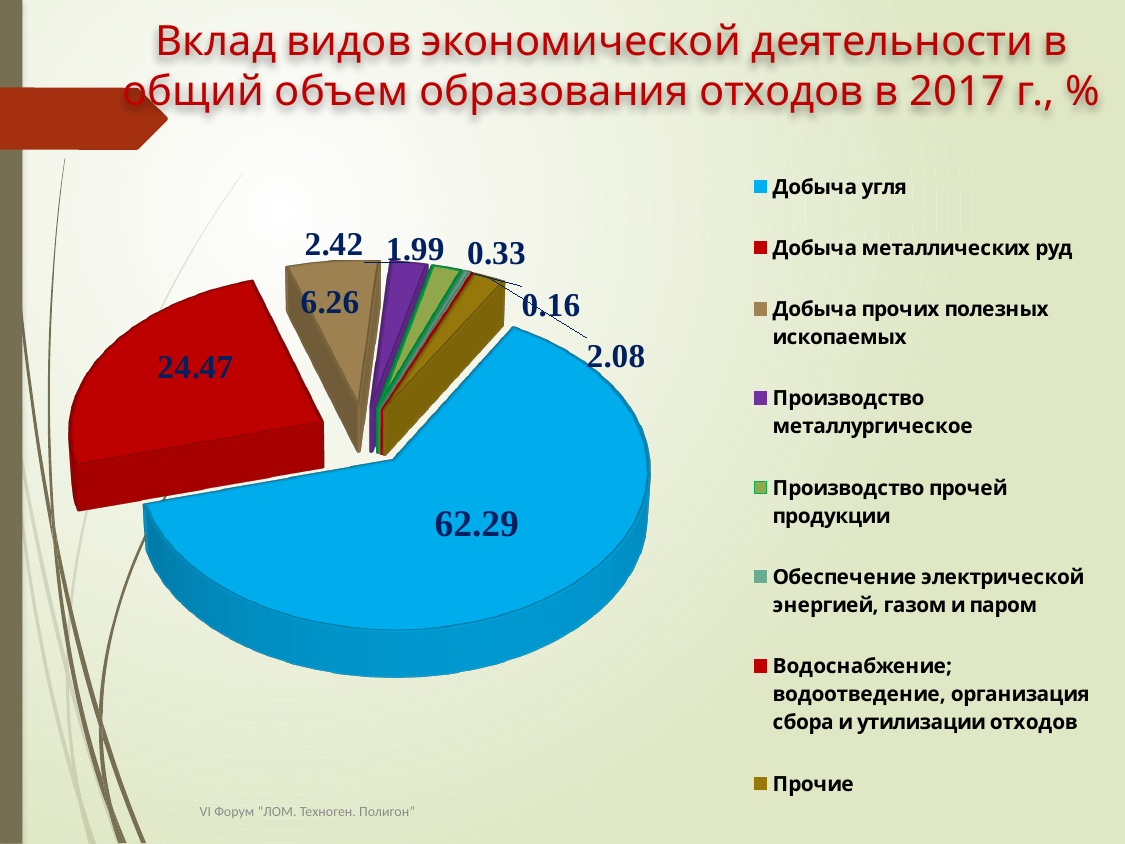
What is the value for Прочие? 2.08 What type of chart is shown on the slide? pie chart What is the value for Добыча металлических руд? 24.47 What is the difference between the values for Добыча угля and Добыча металлических руд? 37.82 What is the value for Добыча угля? 62.29 Which category has the smallest slice of the pie? Водоснабжение; водоотведение, организация сбора и утилизации отходов What is the title of the chart? Вклад видов экономической деятельности в общий объем образования отходов в 2017 г., % How many categories does the legend list? 8 Which category has the largest slice of the pie? Добыча угля Which is larger, the value for Добыча металлических руд or the value for Добыча прочих полезных ископаемых? Добыча металлических руд What colour is the slice for Добыча угля? blue What is the value for Добыча прочих полезных ископаемых? 6.26